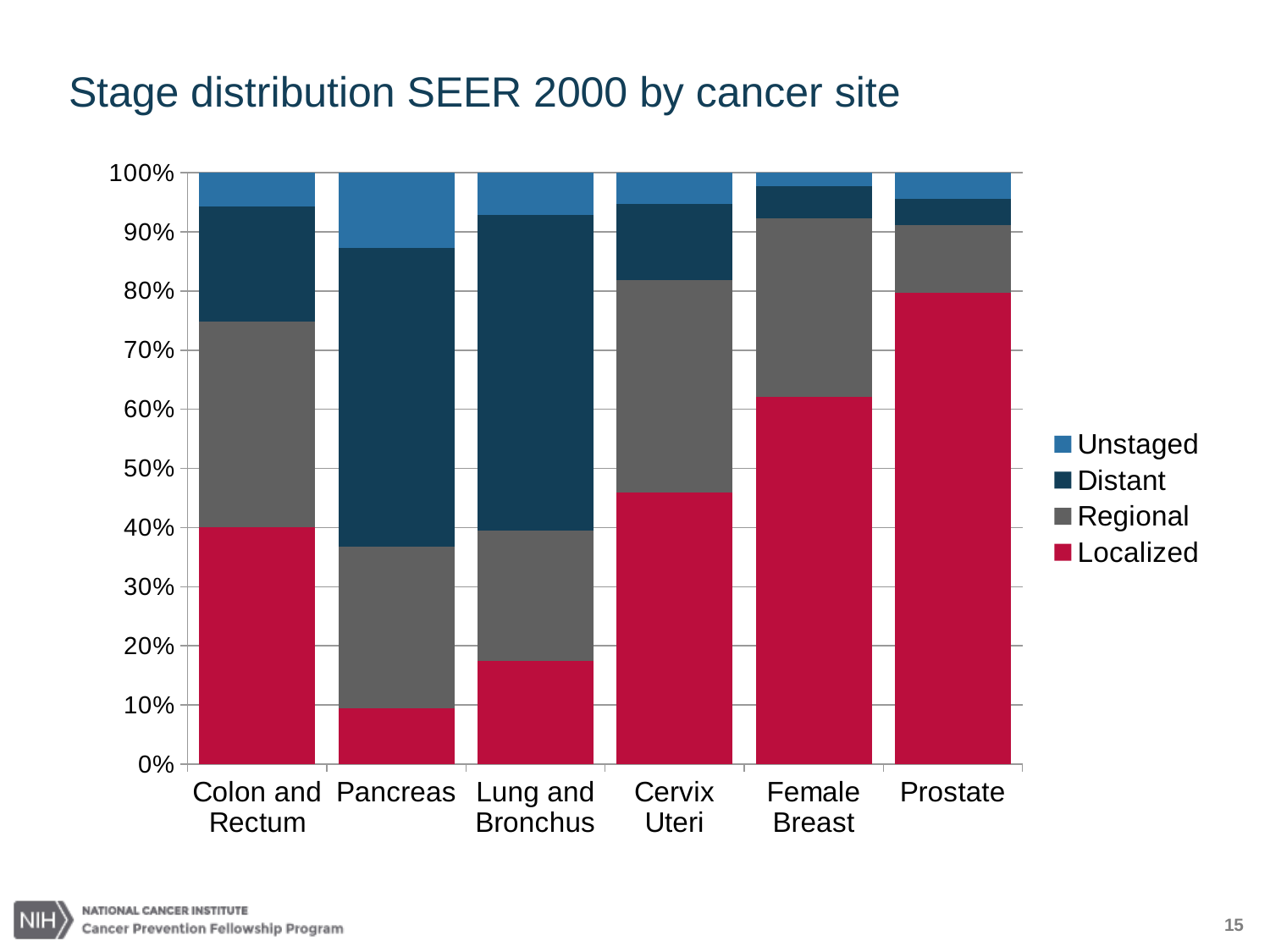
Which cancer site has the smallest Localized share? Pancreas Is the Localized share for Pancreas greater or less than 20%? less Is the Localized share for Female Breast greater or less than 50%? greater Which cancer site has the largest Unstaged share? Pancreas How many cancer sites are shown on the x axis? 6 Which cancer site has the largest Localized share? Prostate Is the Localized share for Lung and Bronchus greater or less than 30%? less Which series is shown in red at the bottom of each bar? Localized What kind of chart is shown on the slide? stacked bar chart How many series does the legend list? 4 Which has the larger Localized share, Female Breast or Cervix Uteri? Female Breast